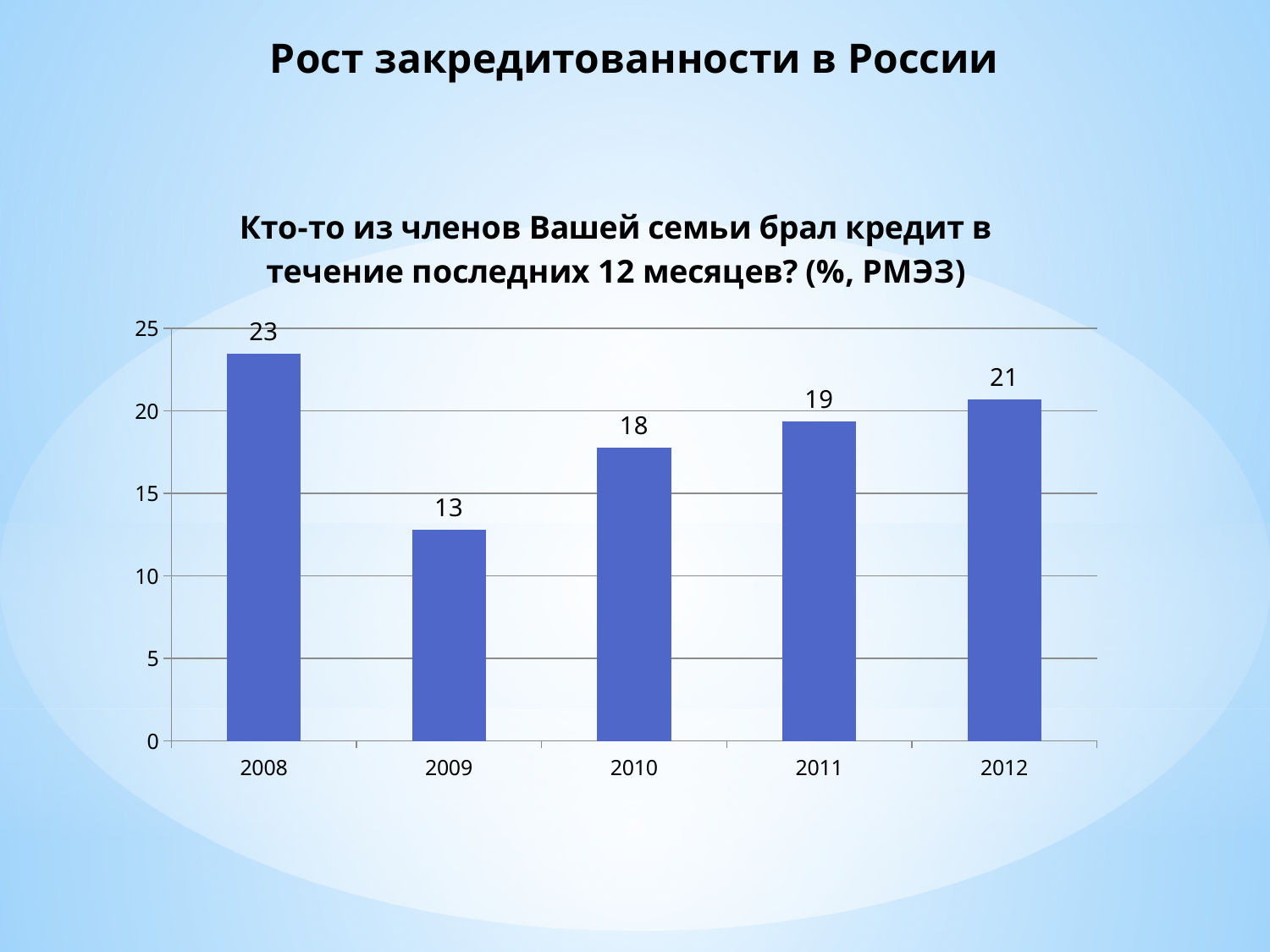
What is the difference between the values for 2012 and 2010? 3 What is the value for 2012? 21 How many years are shown on the x axis? 5 Do the values rise or fall from 2009 to 2012? rise Which year has the lowest value? 2009 What is the value for 2009? 13 Which is larger, the value for 2011 or the value for 2012? 2012 What kind of chart is shown on the slide? bar chart Which year has the highest value? 2008 What is the difference between the values for 2008 and 2009? 10 What is the value for 2008? 23 Is the value for 2010 greater or less than 15? greater